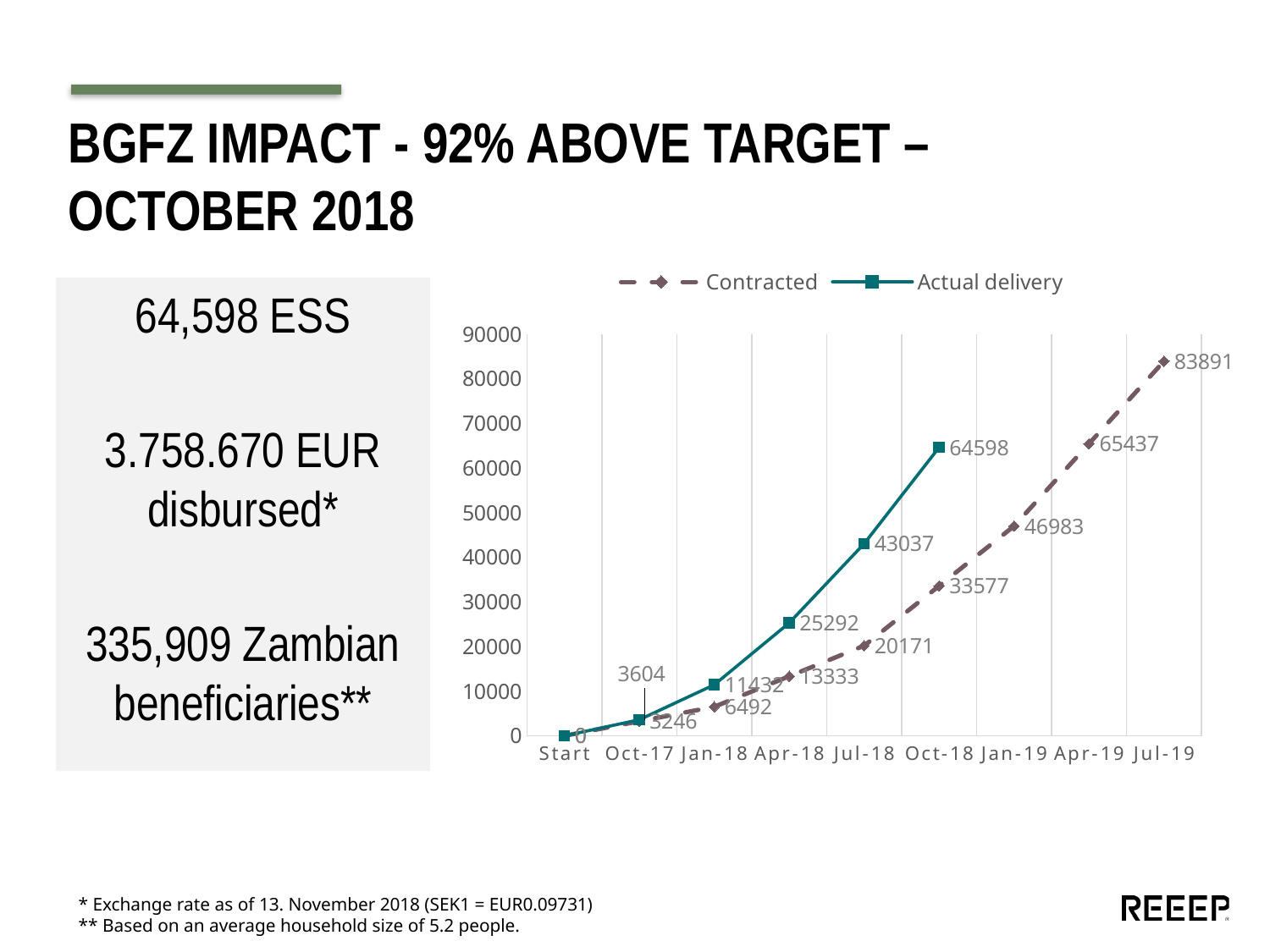
What kind of chart is shown on the slide? Line chart At Oct-18, what is the difference between the Actual delivery value and the Contracted value? 31021 Is the Contracted value at Jan-19 greater or less than 50000? less What is the Actual delivery value at Oct-18? 64598 What is the Contracted value at Apr-18? 13333 What is the Contracted value at Jul-19? 83891 Does the Actual delivery series rise or fall from Start to Oct-18? Rise At Jul-18, which series has the larger value, Contracted or Actual delivery? Actual delivery How many series does the chart legend list? 2 At which x-axis point does the Contracted series reach its highest value? Jul-19 How many points are labelled along the x axis? 9 What is the Actual delivery value at Jan-18? 11432